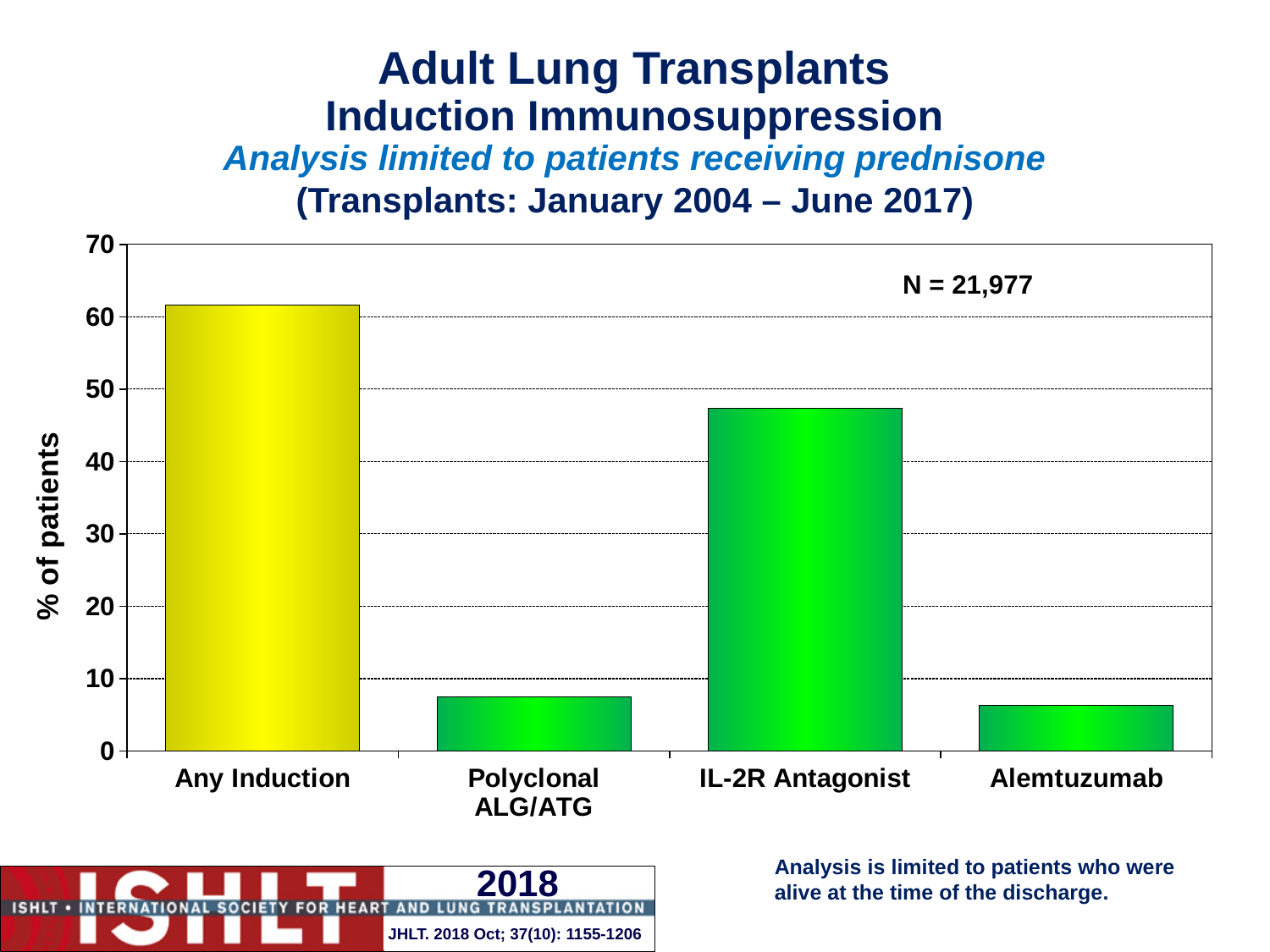
What kind of chart is shown on the slide? bar chart Is the value for IL-2R Antagonist greater or less than 50? less Which is larger, the value for Any Induction or the value for IL-2R Antagonist? Any Induction Which is larger, the value for IL-2R Antagonist or the value for Polyclonal ALG/ATG? IL-2R Antagonist Is the value for Any Induction greater or less than 60? greater Which category has the highest percentage of patients? Any Induction Is the value for Alemtuzumab greater or less than 10? less What is the N value shown on the chart? N = 21,977 How many categories are shown on the x axis of the chart? 4 What is the label on the y axis of the chart? % of patients